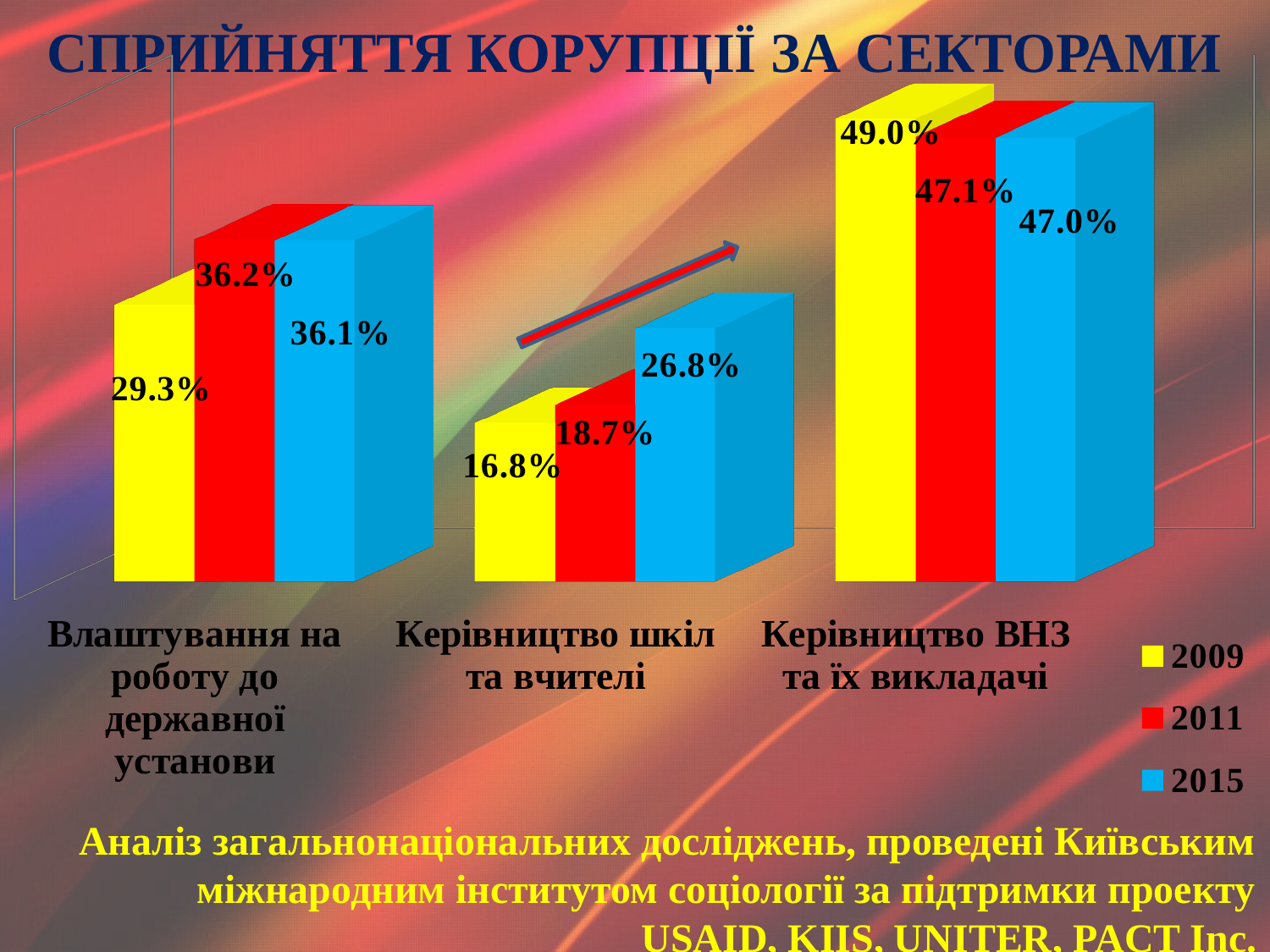
Which category has the highest value for 2009? Керівництво ВНЗ та їх викладачі What is the title of the chart? СПРИЙНЯТТЯ КОРУПЦІЇ ЗА СЕКТОРАМИ Which is larger for "Влаштування на роботу до державної установи": the 2009 value or the 2011 value? 2011 What is the value for 2015 in the category "Керівництво шкіл та вчителі"? 26.8% How many series does the legend list? 3 Do the values for "Керівництво шкіл та вчителі" rise or fall from 2009 to 2015? Rise Which category has the lowest value for 2015? Керівництво шкіл та вчителі How many categories are shown on the x axis? 3 What is the value for 2011 in the category "Керівництво ВНЗ та їх викладачі"? 47.1% What kind of chart is shown on the slide? Bar chart What is the value for 2009 in the category "Влаштування на роботу до державної установи"? 29.3% What is the difference between the 2015 and 2009 values for "Керівництво шкіл та вчителі"? 10.0%